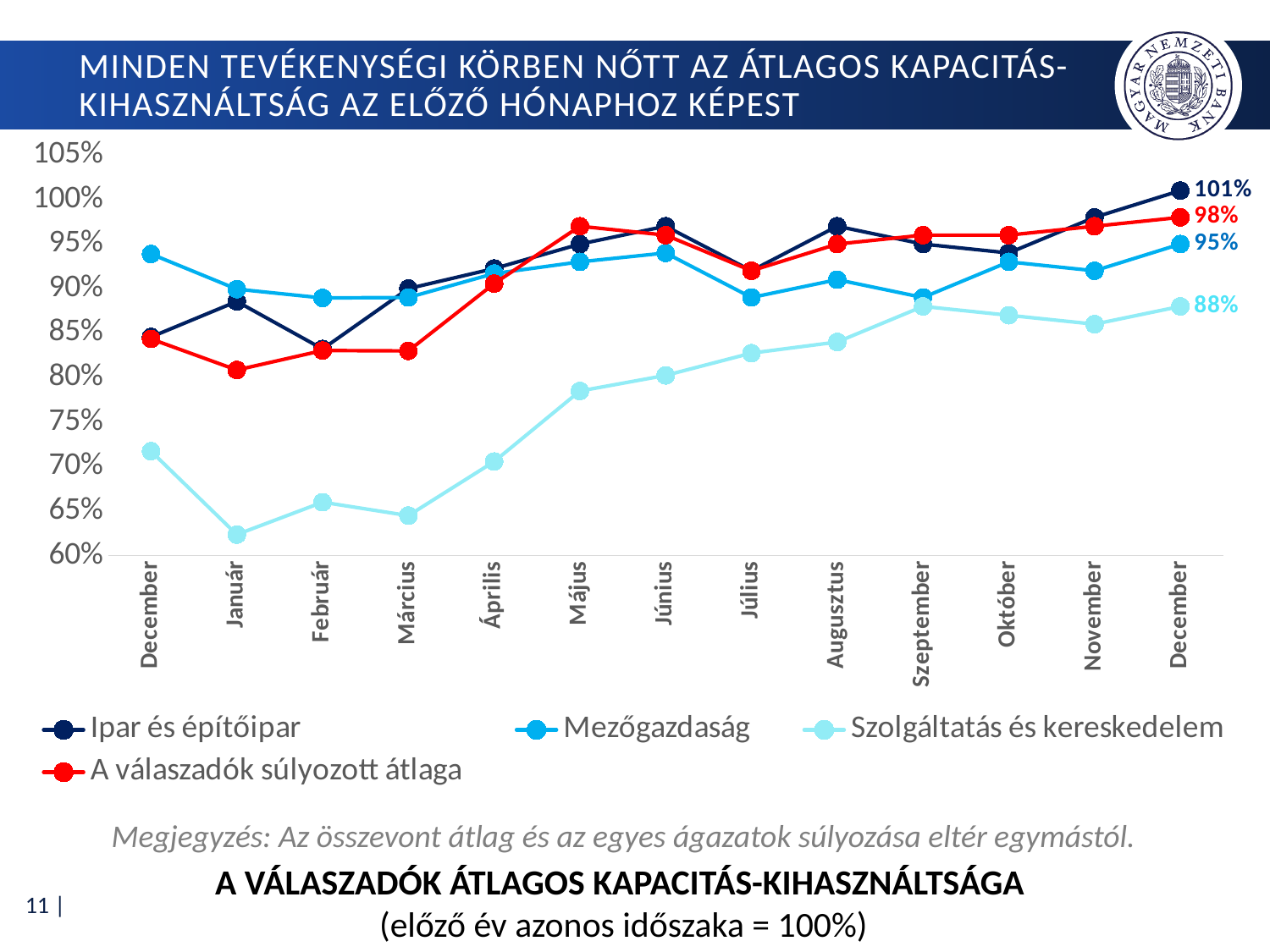
How many months are shown on the x axis? 13 What is the labelled value for A válaszadók súlyozott átlaga at the final December? 98% What is the labelled value for Mezőgazdaság at the final December? 95% Which series has the highest value at the final December? Ipar és építőipar Which series has the lowest value at the final December? Szolgáltatás és kereskedelem What kind of chart is shown on the slide? line chart What is the labelled value for Szolgáltatás és kereskedelem at the final December? 88% How many series does the legend list? 4 Is the value for Szolgáltatás és kereskedelem in Január greater or less than 65%? less What is the labelled value for Ipar és építőipar at the final December on the x axis? 101% At the final December, which is larger: the value for Mezőgazdaság or the value for A válaszadók súlyozott átlaga? A válaszadók súlyozott átlaga At the final December, what is the difference between the labelled values for Ipar és építőipar and Szolgáltatás és kereskedelem? 13 percentage points